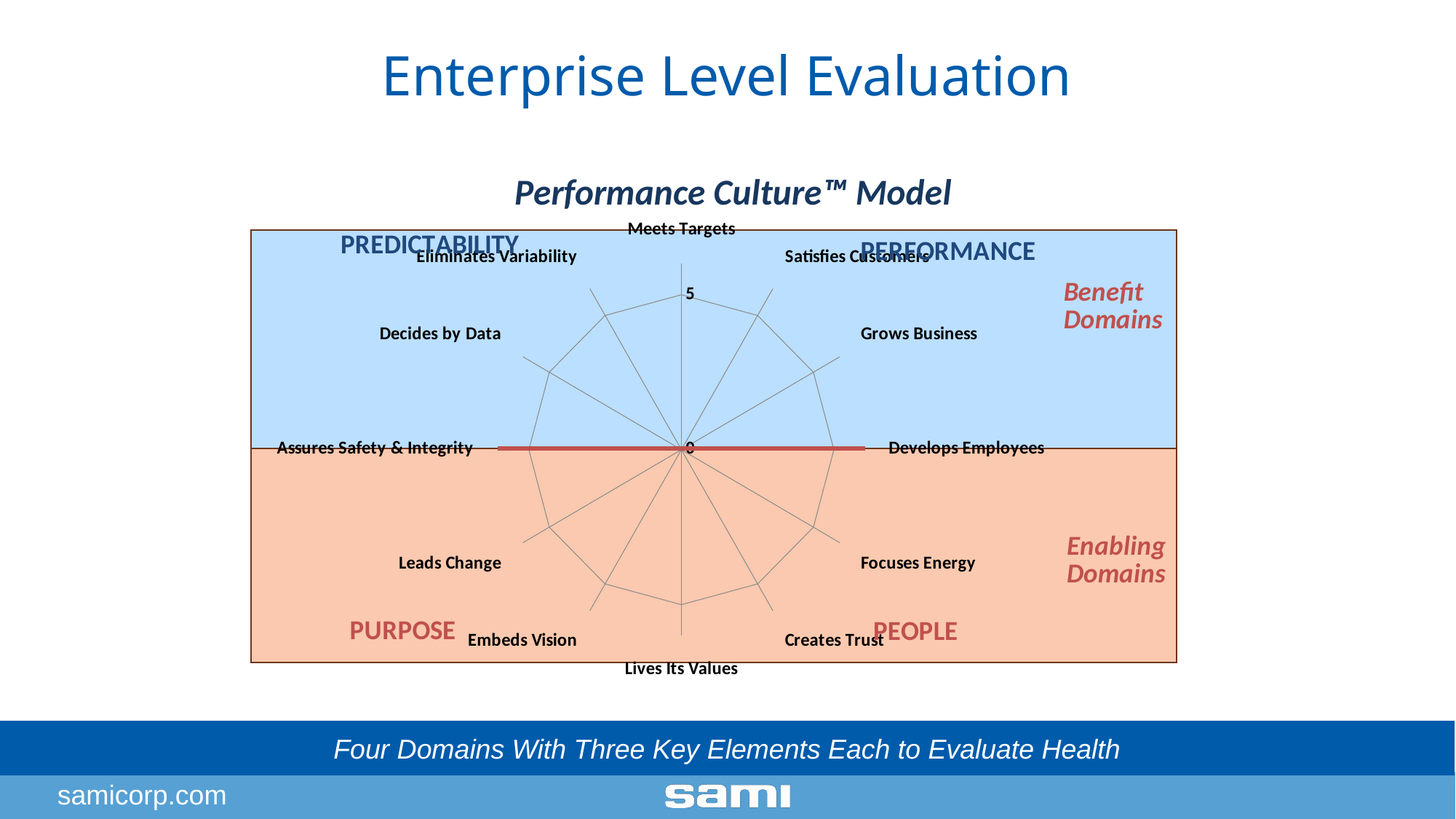
Which two domains are labelled as Enabling Domains on the chart? Purpose and People Which category label sits at the bottom of the radar chart? Lives Its Values How many domains does the chart divide the elements into? 4 Which category label sits at the top of the radar chart? Meets Targets How many categories (key elements) are plotted around the radar chart? 12 Which two domains are labelled as Benefit Domains on the chart? Predictability and Performance What is the title of the chart? Performance Culture™ Model Which category is directly opposite Assures Safety & Integrity on the radar chart? Develops Employees What is the highest value shown on the radar chart's axis? 5 What is the lowest value shown on the radar chart's axis? 0 What kind of chart is shown on the slide? Radar chart